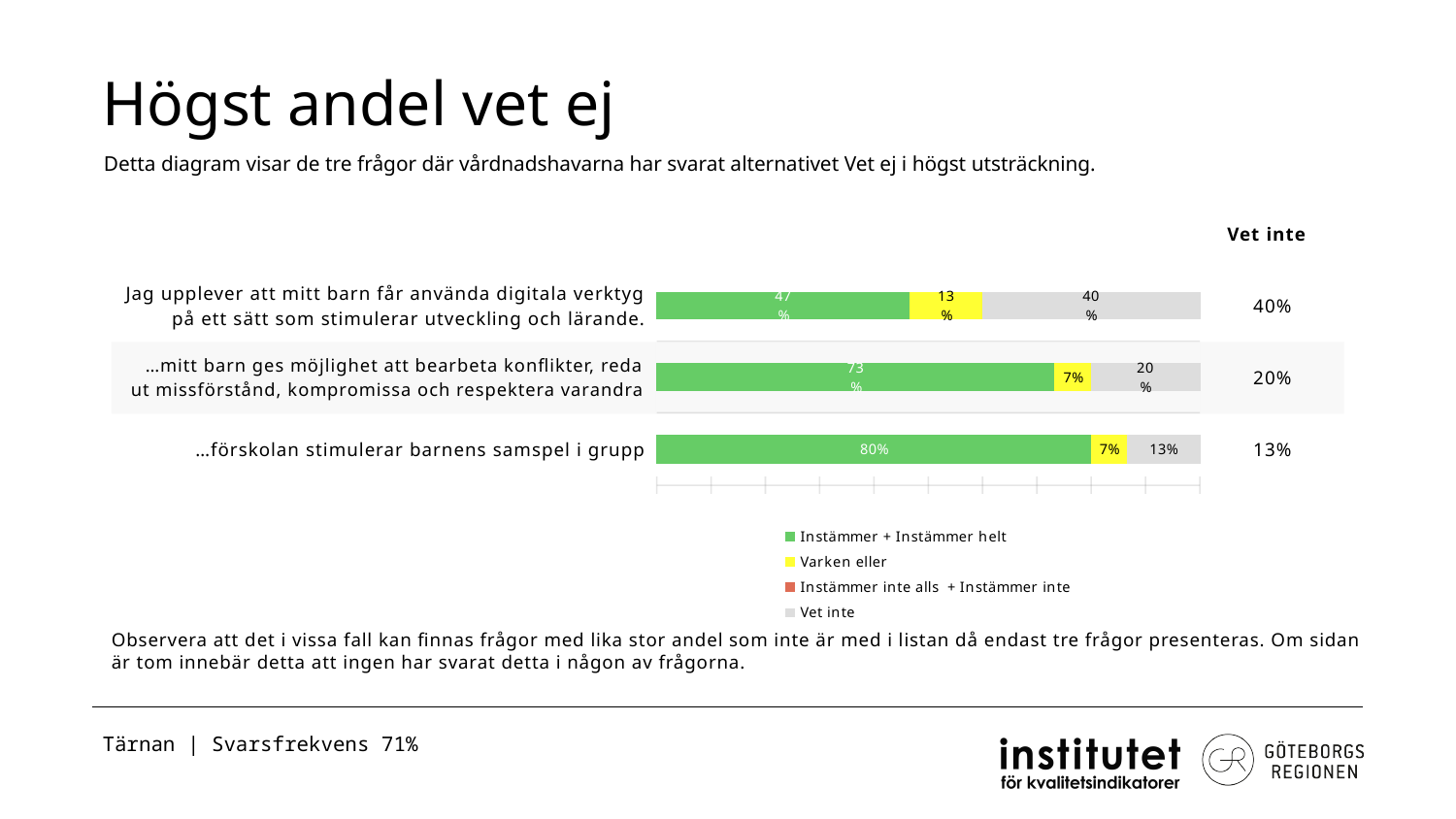
Which category has the highest 'Vet inte' share? Jag upplever att mitt barn får använda digitala verktyg på ett sätt som stimulerar utveckling och lärande. What kind of chart is shown on the slide? Stacked bar chart What is the difference between the 'Vet inte' values for the digital tools question (40%) and the conflict-handling question (20%)? 20 percentage points How many series does the legend list? 4 What is the 'Vet inte' value for 'Jag upplever att mitt barn får använda digitala verktyg på ett sätt som stimulerar utveckling och lärande.'? 40% What is the total of the stacked bar for '…förskolan stimulerar barnens samspel i grupp' (80% + 7% + 13%)? 100% What is the heading of the column of values shown to the right of the bars? Vet inte What is the 'Varken eller' value for '…mitt barn ges möjlighet att bearbeta konflikter, reda ut missförstånd, kompromissa och respektera varandra'? 7% How many categories (questions) are plotted in the chart? 3 What is the 'Instämmer + Instämmer helt' value for '…förskolan stimulerar barnens samspel i grupp'? 80% Which category has the lowest 'Instämmer + Instämmer helt' share? Jag upplever att mitt barn får använda digitala verktyg på ett sätt som stimulerar utveckling och lärande. Which is larger: the 'Instämmer + Instämmer helt' value for '…förskolan stimulerar barnens samspel i grupp' or for '…mitt barn ges möjlighet att bearbeta konflikter, reda ut missförstånd, kompromissa och respektera varandra'? …förskolan stimulerar barnens samspel i grupp